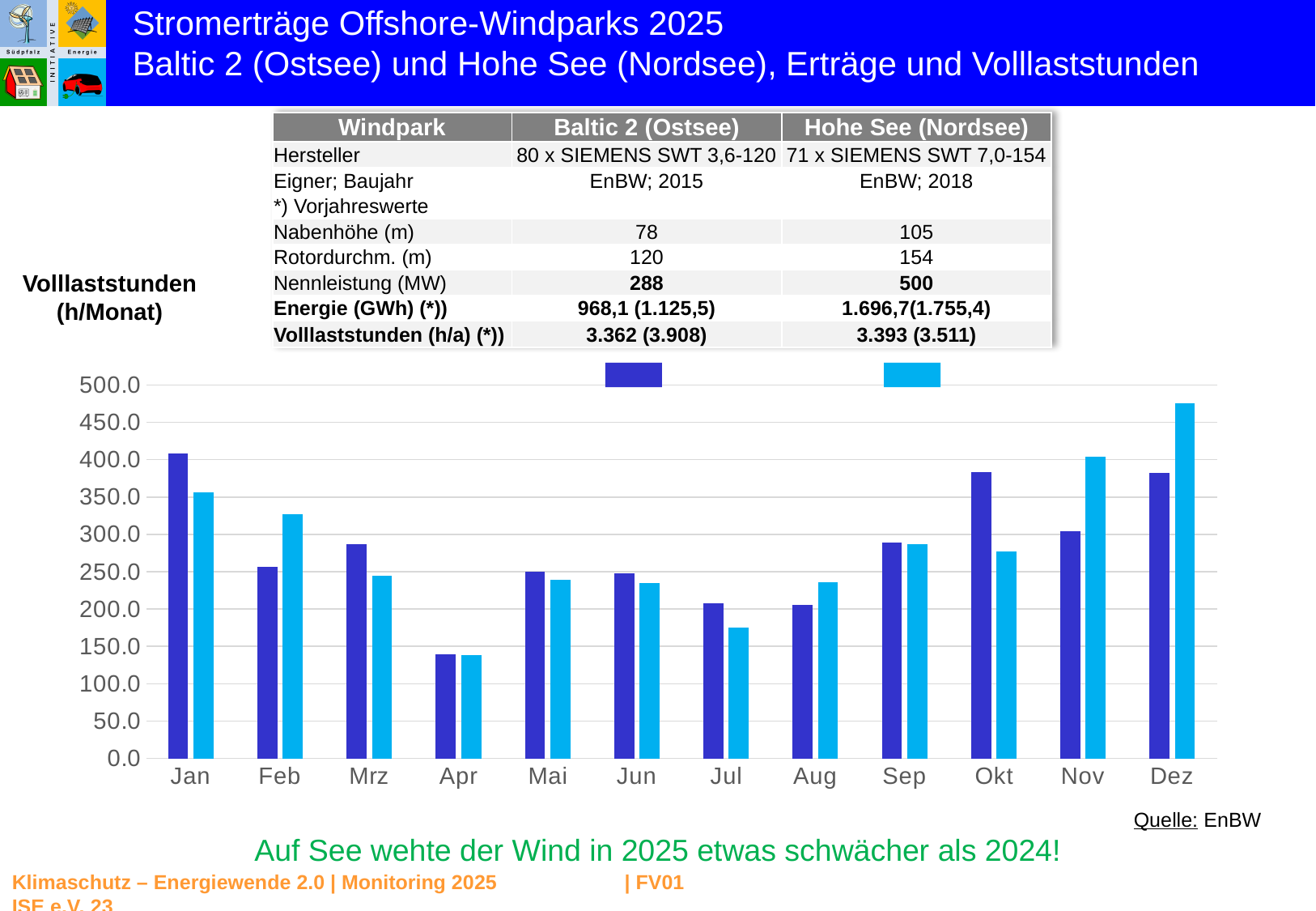
In which month is the dark blue bar lowest? Apr What kind of chart is shown on the slide? bar chart Is the light blue bar for Jul greater or less than 200? less In which month is the light blue bar highest? Dez In Okt, which bar is taller, the dark blue or the light blue one? dark blue Is the dark blue bar for Jan greater or less than 400? greater Is the light blue bar for Dez greater or less than 450? greater How many months are shown on the x axis of the chart? 12 In Feb, which bar is taller, the dark blue or the light blue one? light blue In which month is the dark blue bar highest? Jan Do the dark blue bars rise or fall from Jan to Apr? fall How many series does the chart's legend show? 2